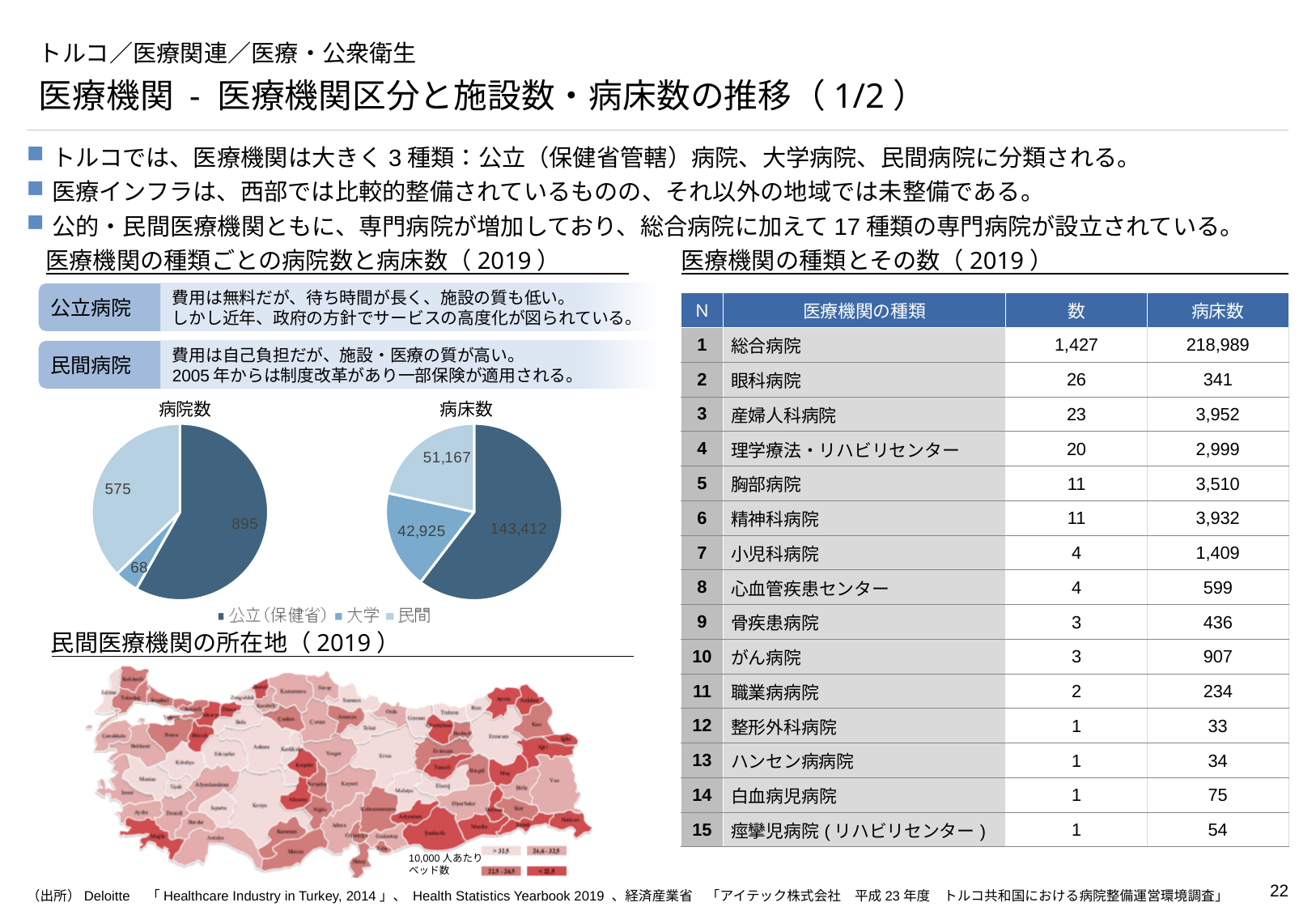
In the 病床数 pie chart, which is larger, the 民間 value or the 大学 value? 民間 In the 病院数 pie chart, what is the value for 大学? 68 How many series does the legend shared by the two pie charts list? 3 In the 病院数 pie chart, which category has the largest slice? 公立(保健省) In the 病床数 pie chart, which category has the smallest slice? 大学 In the 病床数 pie chart, what is the value for 大学? 42,925 What kind of chart is the 病院数 chart? pie chart In the 病院数 pie chart, what is the value for 公立(保健省)? 895 In the 病院数 pie chart, what is the total of all three slices? 1,538 In the 病床数 pie chart, what is the difference between the 民間 value and the 大学 value? 8,242 In the 病床数 pie chart, what is the value for 民間? 51,167 In the 病院数 pie chart, what is the difference between the 公立(保健省) value and the 民間 value? 320